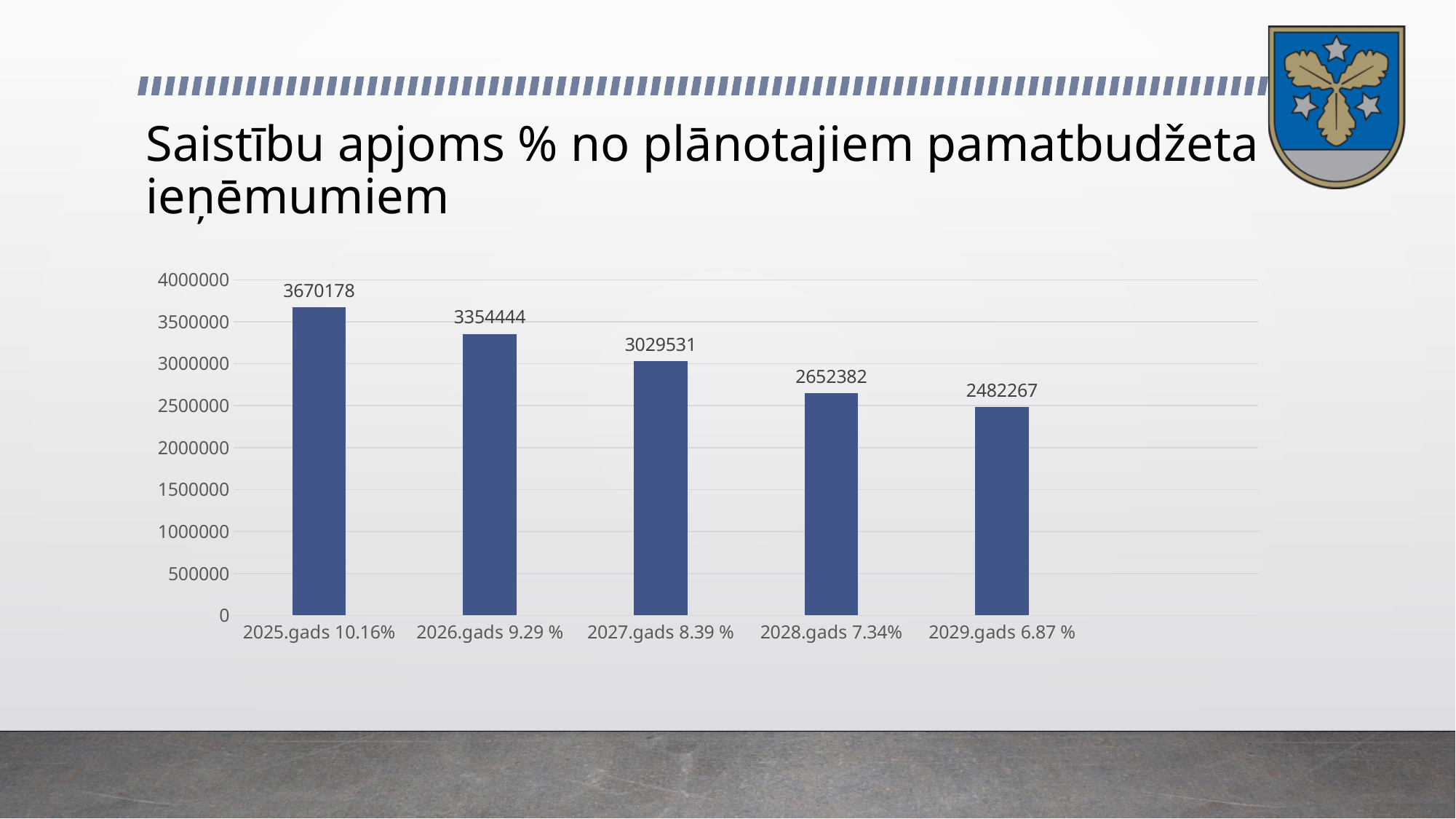
What is the value of the bar for 2027.gads 8.39 %? 3029531 What is the difference between the values for 2028.gads 7.34% and 2029.gads 6.87 %? 170115 Which category has the lowest bar? 2029.gads 6.87 % Which is larger, the value for 2026.gads 9.29 % or the value for 2028.gads 7.34%? 2026.gads 9.29 % Which category has the highest bar? 2025.gads 10.16% Do the values rise or fall from 2025.gads to 2029.gads? fall How many bars are shown in the chart? 5 What kind of chart is shown on the slide? bar chart What is the value of the bar for 2025.gads 10.16%? 3670178 Is the value for 2027.gads 8.39 % greater or less than 3500000? less What is the difference between the values for 2025.gads 10.16% and 2026.gads 9.29 %? 315734 What is the value of the bar for 2029.gads 6.87 %? 2482267